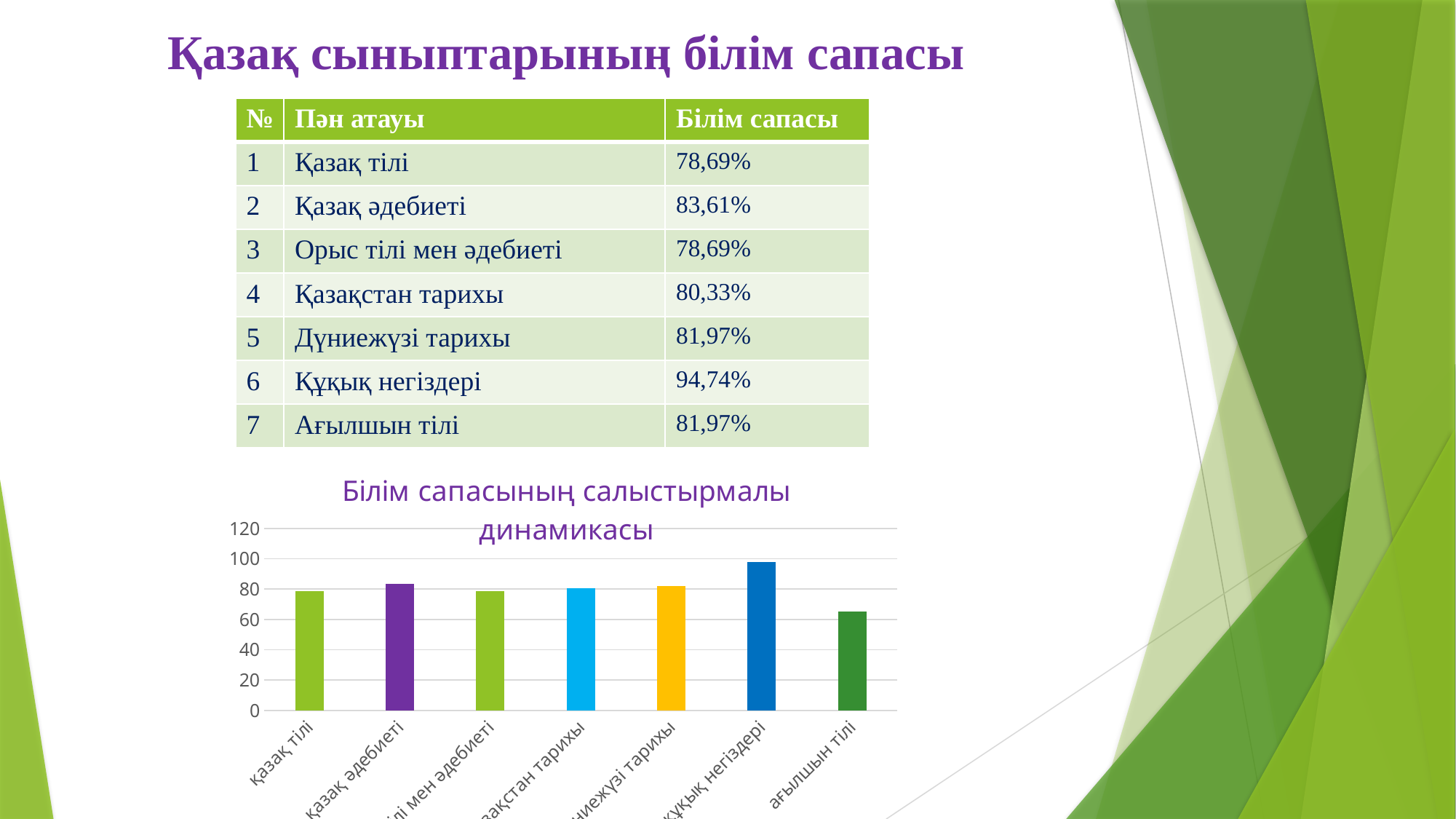
Which bar is taller: Қазақ әдебиеті or Ағылшын тілі? Қазақ әдебиеті Which category has the tallest bar in the chart? Құқық негіздері Is the value for Ағылшын тілі greater or less than 80? less How many bars are plotted in the chart? 7 What kind of chart is shown on the slide? bar chart What is the highest value shown on the chart's vertical axis? 120 Which category has the shortest bar in the chart? Ағылшын тілі Is the value for Құқық негіздері greater or less than 80? greater Which bar is taller: Құқық негіздері or Ағылшын тілі? Құқық негіздері Is the value for Қазақ тілі greater or less than 60? greater What is the title of the chart? Білім сапасының салыстырмалы динамикасы